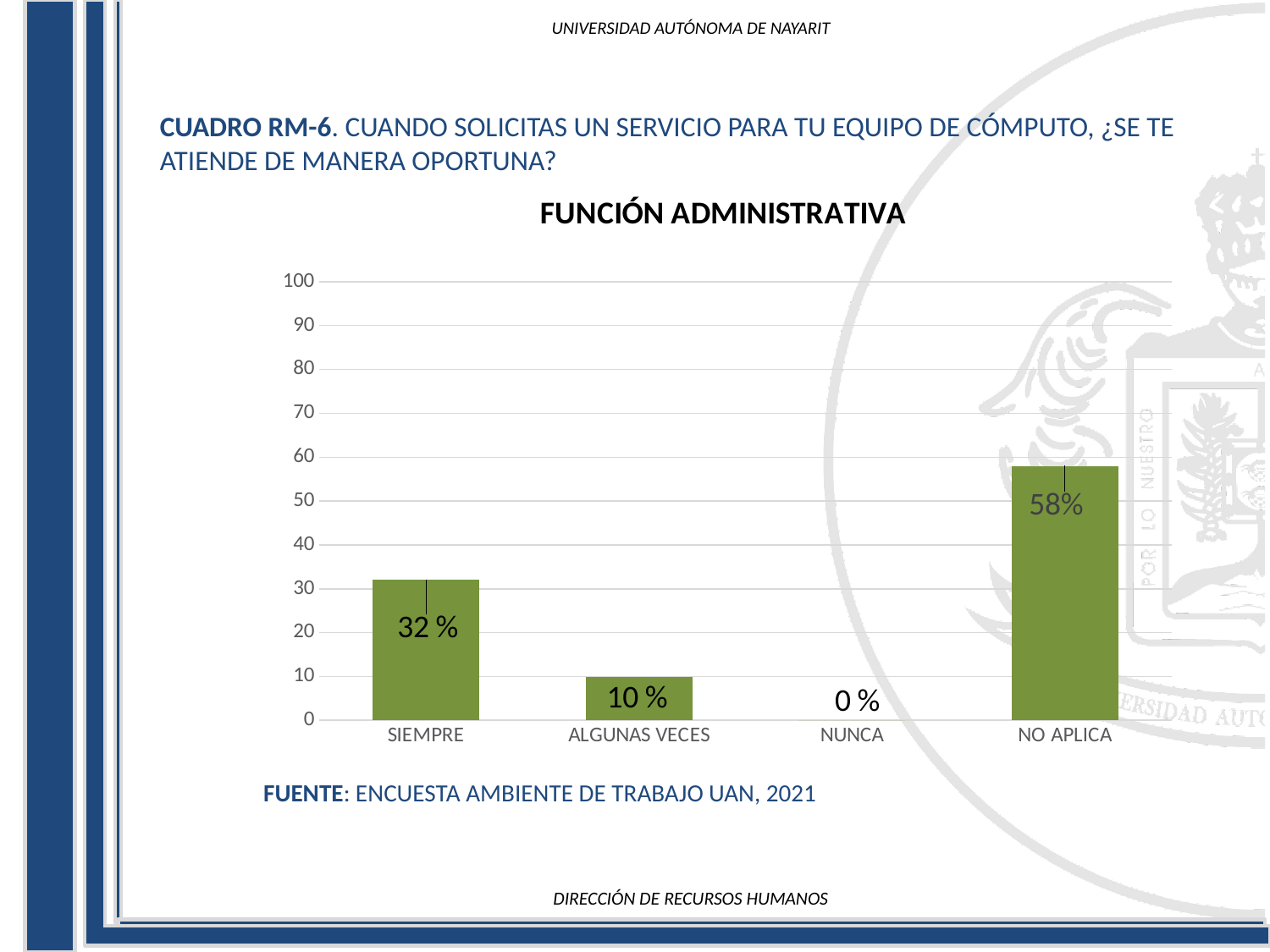
What kind of chart is shown on the slide? bar chart Is the value for NO APLICA greater or less than 50? greater Which category has the lowest value? NUNCA How many categories are shown on the x axis? 4 What is the value for NO APLICA? 58% Which category has the highest value? NO APLICA What is the value for SIEMPRE? 32 % What is the value for ALGUNAS VECES? 10 % What is the title of the chart? FUNCIÓN ADMINISTRATIVA Which is larger, the value for SIEMPRE or the value for ALGUNAS VECES? SIEMPRE What is the value for NUNCA? 0 % What is the difference between the values for NO APLICA and SIEMPRE? 26